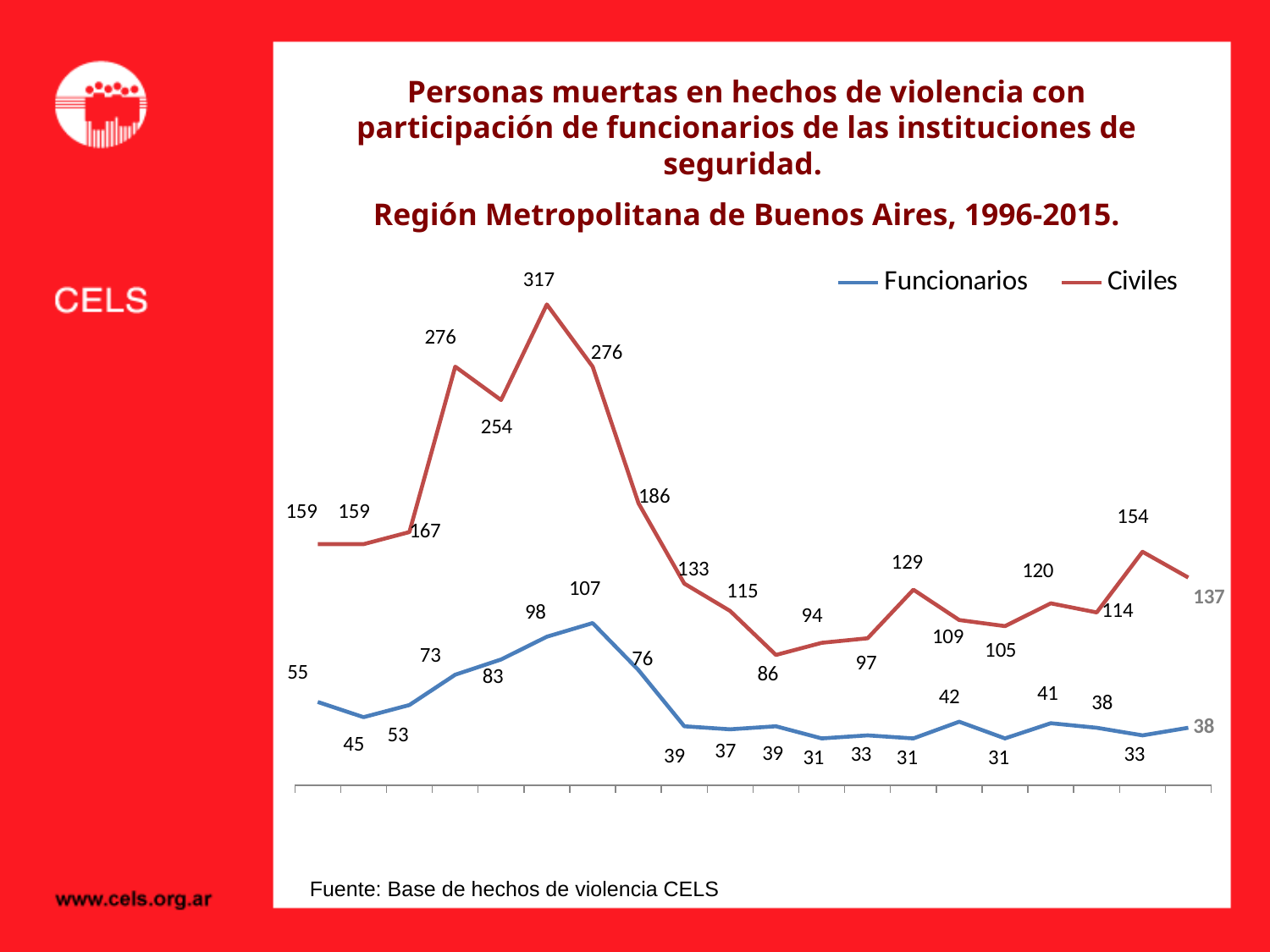
What is the value of the last (rightmost) point of the Civiles series? 137 What are the two series named in the legend? Funcionarios and Civiles What is the value of the last (rightmost) point of the Funcionarios series? 38 What is the highest value reached by the Funcionarios series? 107 What is the highest value reached by the Civiles series? 317 At the rightmost point, which series has the larger value, Funcionarios or Civiles? Civiles How many series does the legend list? 2 What is the lowest value reached by the Civiles series? 86 What is the difference between the peak value of the Civiles series and the peak value of the Funcionarios series? 210 What kind of chart is shown on the slide? line chart What is the value of the first (leftmost) point of the Civiles series? 159 What is the lowest value reached by the Funcionarios series? 31